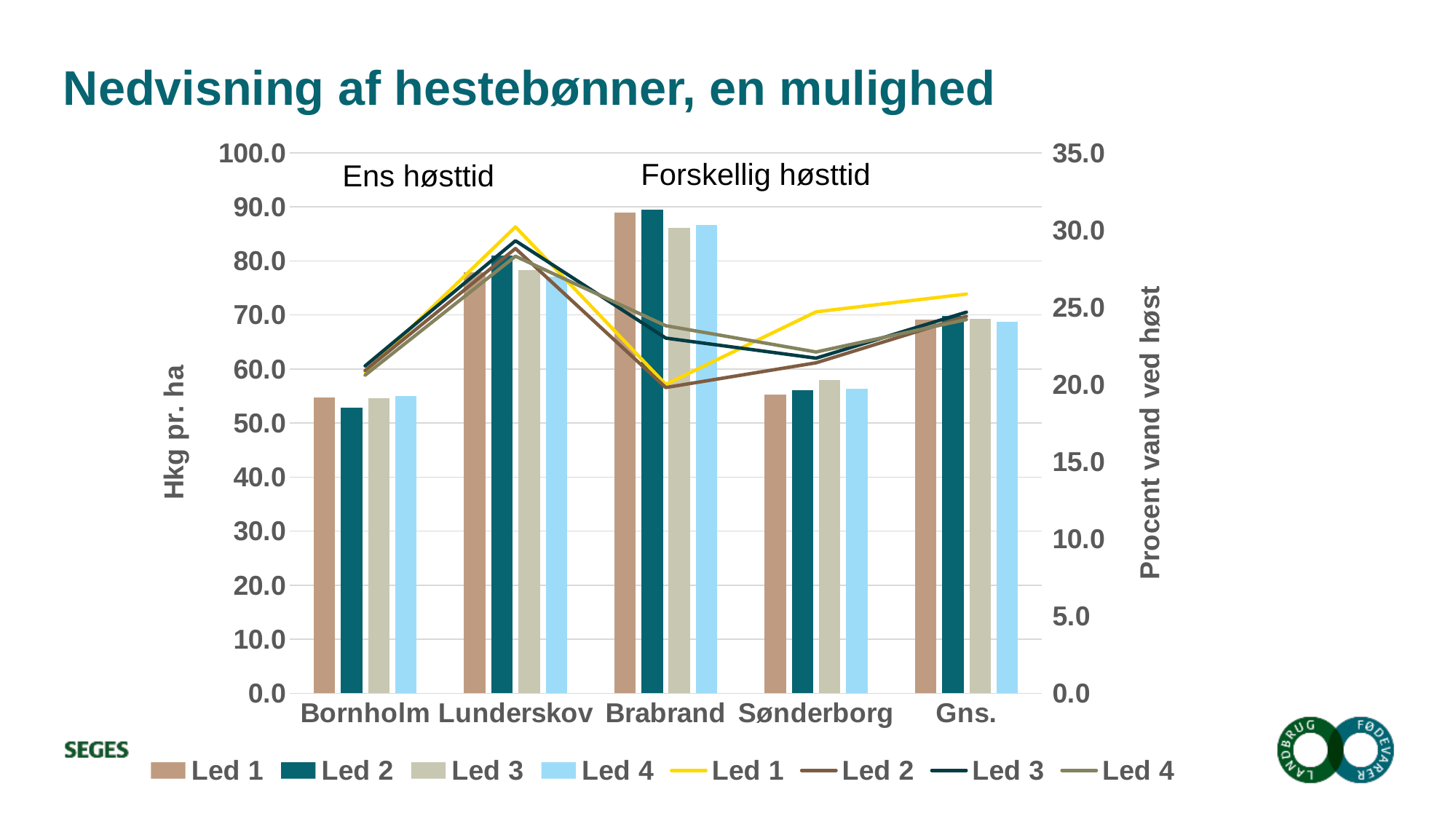
Is the Led 1 bar for Brabrand greater or less than 80 Hkg pr. ha? greater What kind of chart is shown on the slide? A combined bar and line chart What is the title of the right-hand vertical axis? Procent vand ved høst What is the title of the chart on the slide? Nedvisning af hestebønner, en mulighed Is the Led 3 bar for Lunderskov greater or less than 70 Hkg pr. ha? greater Which is larger, the Led 2 bar for Brabrand or the Led 2 bar for Sønderborg? Brabrand How many series does the legend list? 8 Which category has the highest bars (Hkg pr. ha)? Brabrand Does the Led 1 line (Procent vand ved høst) rise or fall from Brabrand to Gns.? rise Is the Led 3 line value for Bornholm greater or less than 20 percent vand ved høst? greater How many categories are shown on the x axis? 5